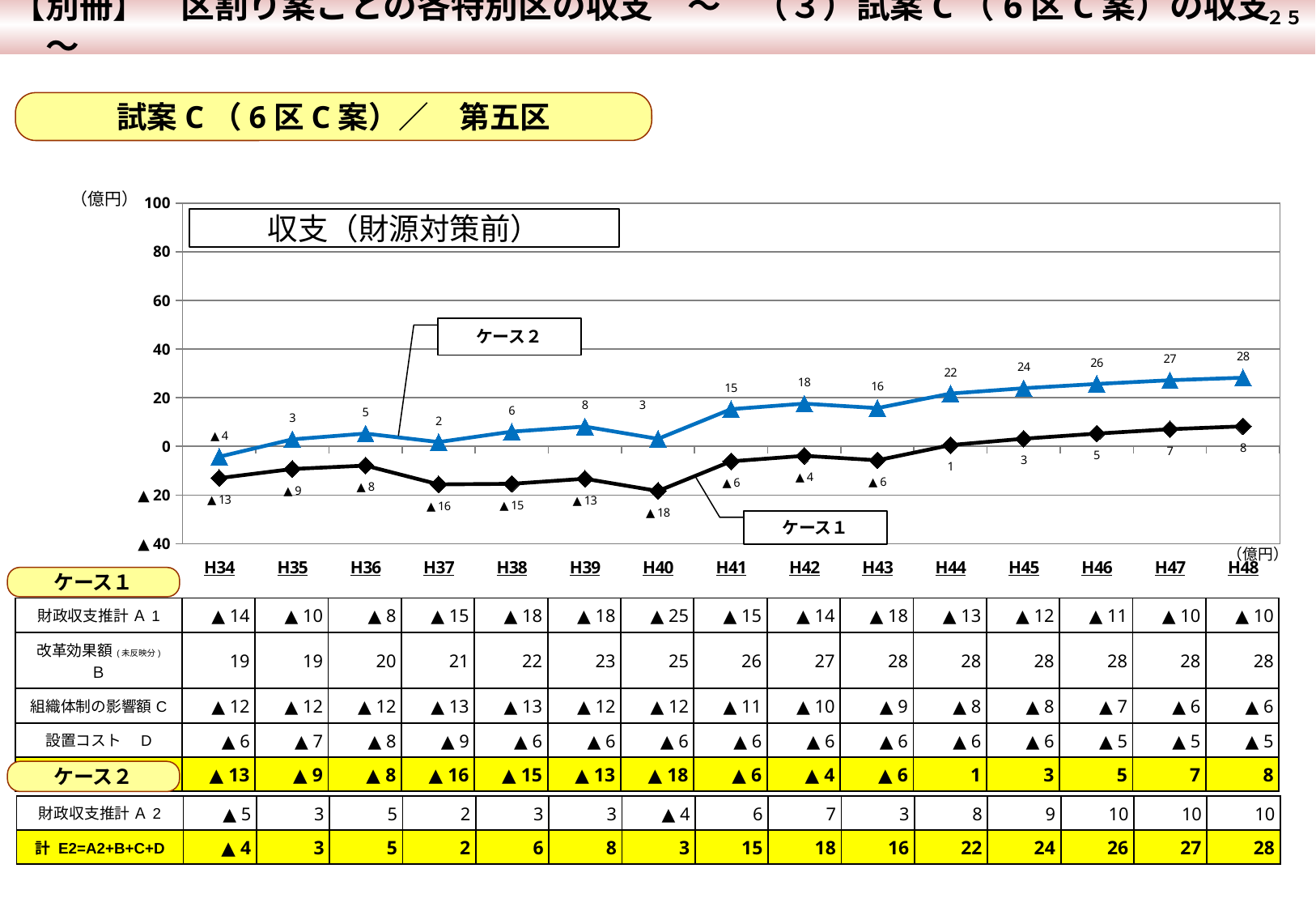
In which year does ケース1 have its lowest value? H40 Which series has the larger value in H44, ケース1 or ケース2? ケース2 What is the value for ケース2 in H42? 18 How many years (categories) are shown on the x axis of the chart? 15 From H44 to H48, do the ケース1 values rise or fall? rise What is the title shown inside the chart area? 収支（財源対策前） What is the value for ケース1 in H40? ▲18 In which year does ケース2 reach its highest value? H48 How many series are plotted in the chart? 2 What is the difference between the ケース2 value in H48 and the ケース2 value in H41? 13 What type of chart is shown on the slide? line chart What is the value for ケース2 in H48? 28